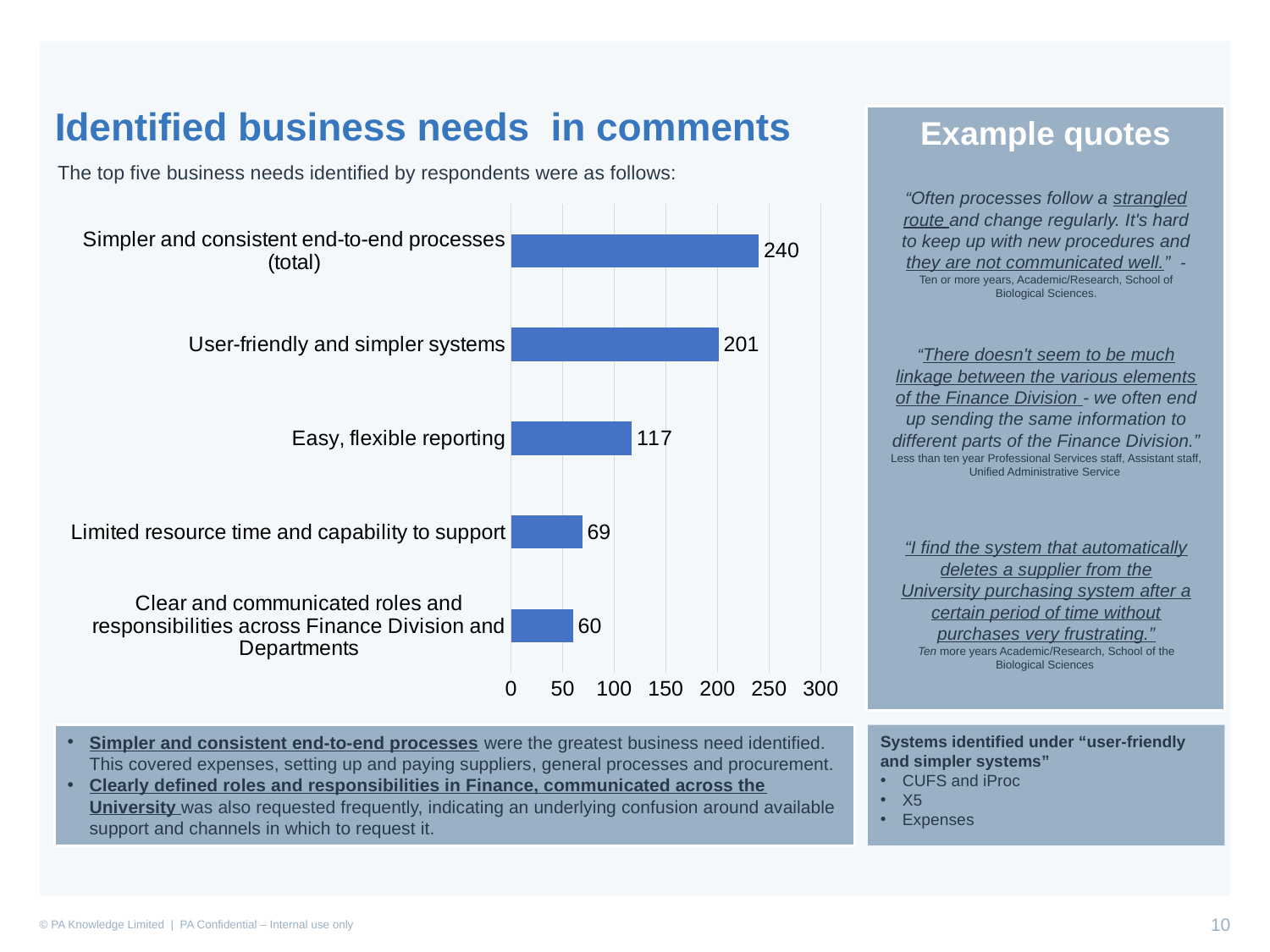
What is the value for "User-friendly and simpler systems"? 201 Which category has the lowest value? Clear and communicated roles and responsibilities across Finance Division and Departments Which category has the highest value? Simpler and consistent end-to-end processes (total) Which is larger: the value for "Easy, flexible reporting" or the value for "Limited resource time and capability to support"? Easy, flexible reporting What is the difference between the values for "Simpler and consistent end-to-end processes (total)" and "User-friendly and simpler systems"? 39 What kind of chart is shown on the slide? Bar chart What is the value for "Clear and communicated roles and responsibilities across Finance Division and Departments"? 60 What is the difference between the values for "Limited resource time and capability to support" and "Clear and communicated roles and responsibilities across Finance Division and Departments"? 9 What is the value for "Easy, flexible reporting"? 117 Is the value for "Easy, flexible reporting" greater or less than 100? greater What is the value for "Limited resource time and capability to support"? 69 How many categories are shown in the chart? 5